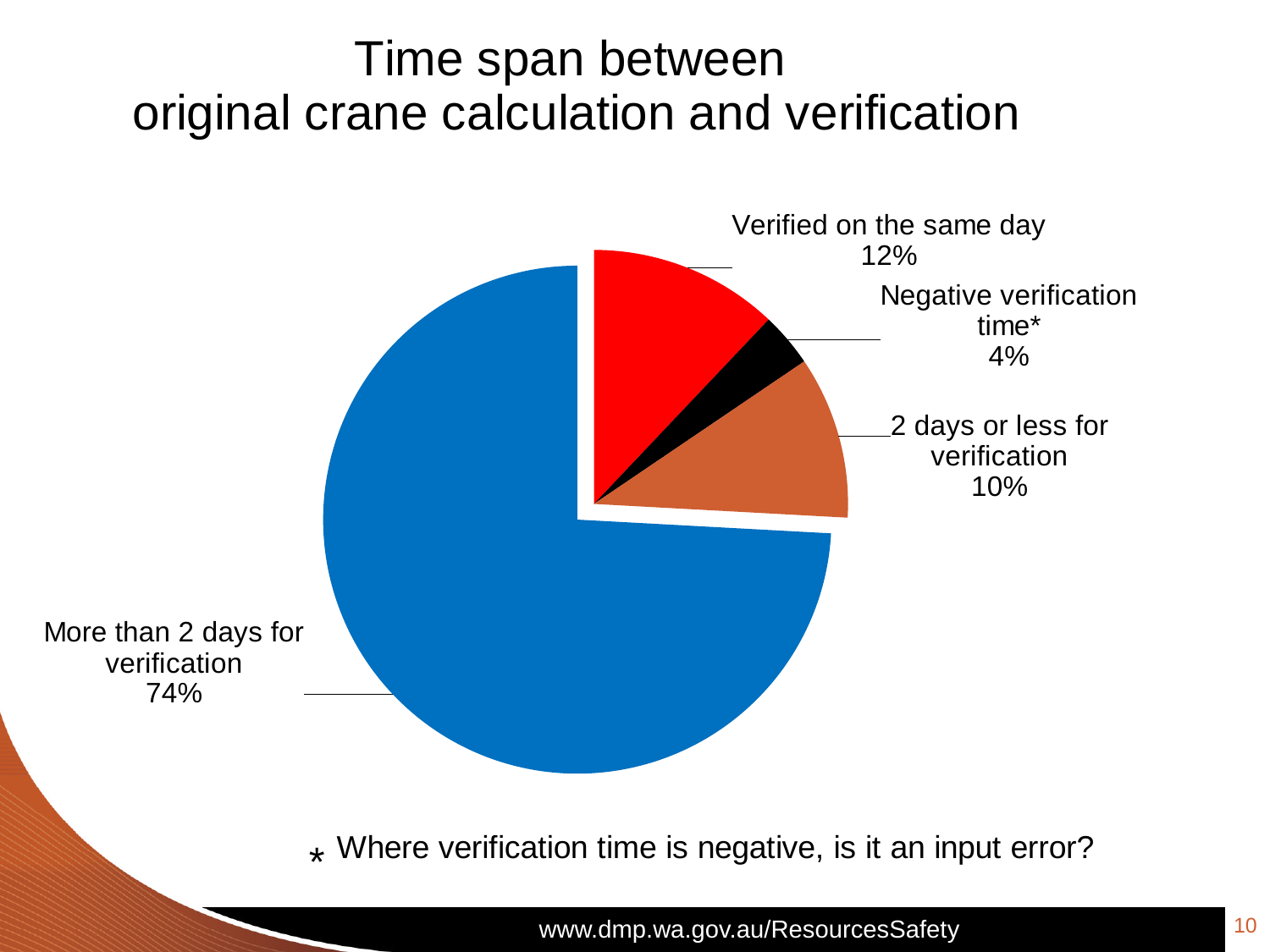
What share of the pie is 'Negative verification time*'? 4% What is the difference in percentage points between 'Verified on the same day' and '2 days or less for verification'? 2% Which slice of the pie is the largest? More than 2 days for verification What share of the pie is 'More than 2 days for verification'? 74% Which is larger: 'Verified on the same day' or 'Negative verification time*'? Verified on the same day Which slice of the pie is the smallest? Negative verification time* What share of the pie is 'Verified on the same day'? 12% What kind of chart is shown on the slide? pie chart What is the difference in percentage points between 'More than 2 days for verification' and 'Verified on the same day'? 62% What colour is the 'More than 2 days for verification' slice? blue How many slices does the pie chart have? 4